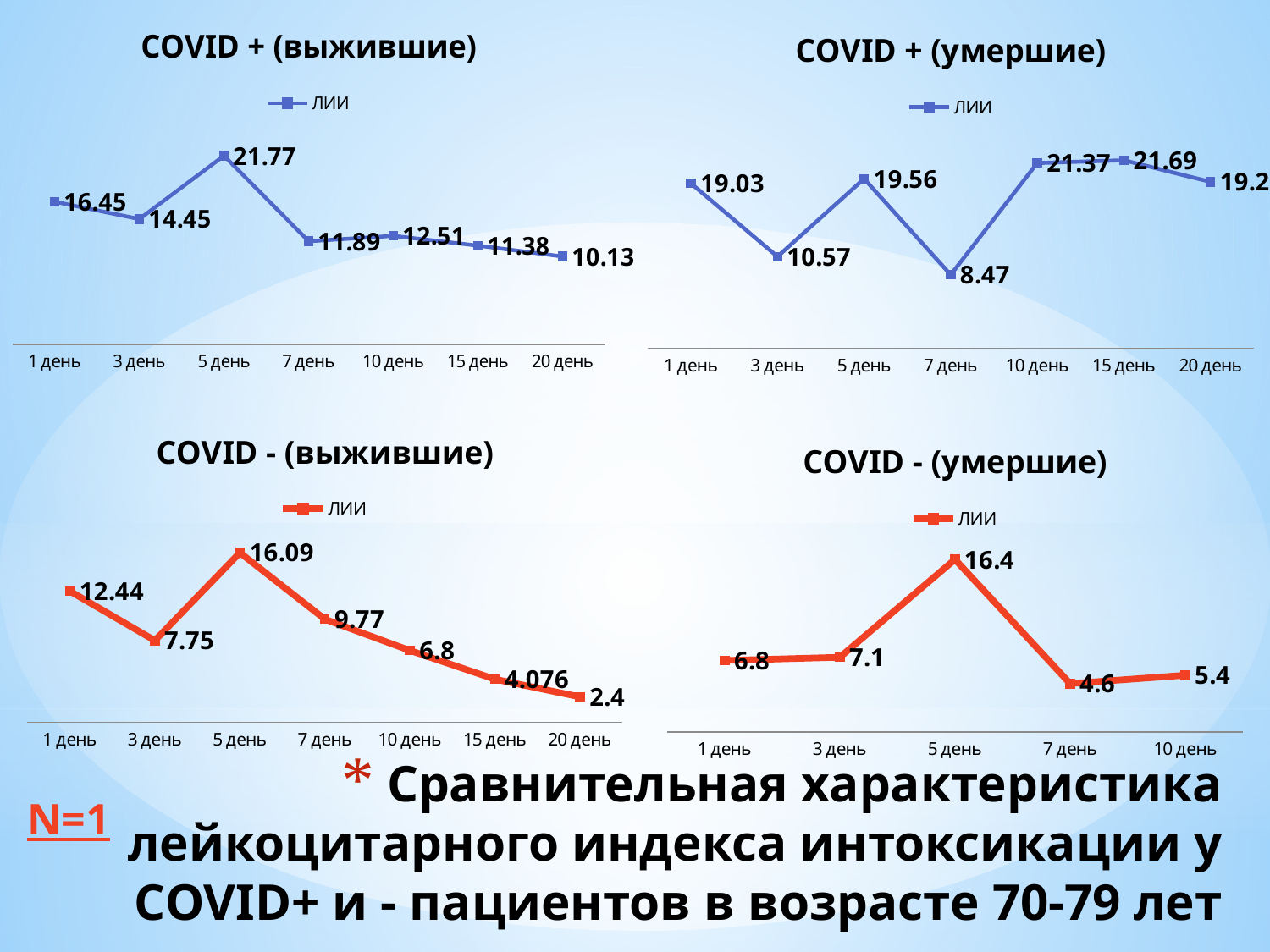
In the chart titled "COVID + (умершие)", what is the difference between the values for 15 день and 7 день? 13.22 In the chart titled "COVID + (умершие)", which category has the highest value? 15 день In the chart titled "COVID + (выжившие)", which category has the lowest value? 20 день In the chart titled "COVID - (умершие)", how many categories are shown on the x axis? 5 In the chart titled "COVID - (умершие)", what is the value for 5 день? 16.4 In the chart titled "COVID + (выжившие)", what is the value for 5 день? 21.77 In the chart titled "COVID - (выжившие)", what is the value for 15 день? 4.076 In the chart titled "COVID - (выжившие)", how many data points are plotted? 7 In the chart titled "COVID - (выжившие)", which is larger, the value for 1 день or the value for 7 день? 1 день What kind of chart is the chart titled "COVID + (выжившие)"? Line chart In the chart titled "COVID - (умершие)", what is the difference between the values for 5 день and 7 день? 11.8 In the chart titled "COVID + (умершие)", what is the value for 7 день? 8.47